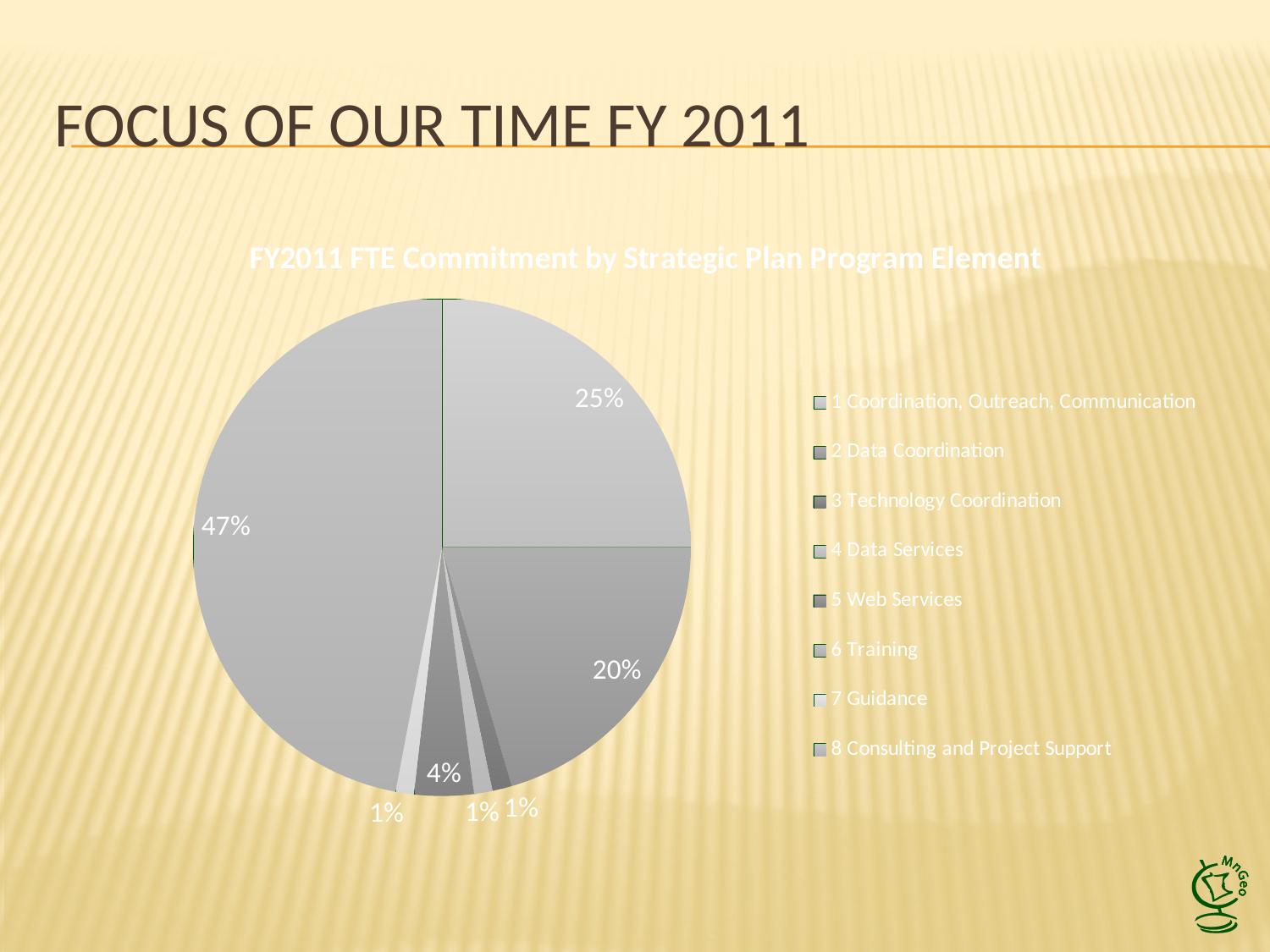
Does the largest slice account for more or less than half of the pie? less What is the difference in percentage points between the largest slice (47%) and the 25% slice? 22 What is the title of the chart? FY2011 FTE Commitment by Strategic Plan Program Element How many slices of the pie are labelled with 1%? 3 Which is larger, the 20% slice or the 4% slice? the 20% slice What kind of chart is shown on the slide? pie chart Which legend entry is listed last? 8 Consulting and Project Support How many entries does the chart's legend list? 8 What is the largest percentage shown on the pie chart? 47% What is the difference in percentage points between the 25% slice and the 20% slice? 5 What is the smallest percentage labelled on the pie chart? 1% What is the combined share of the 25% and 20% slices? 45%